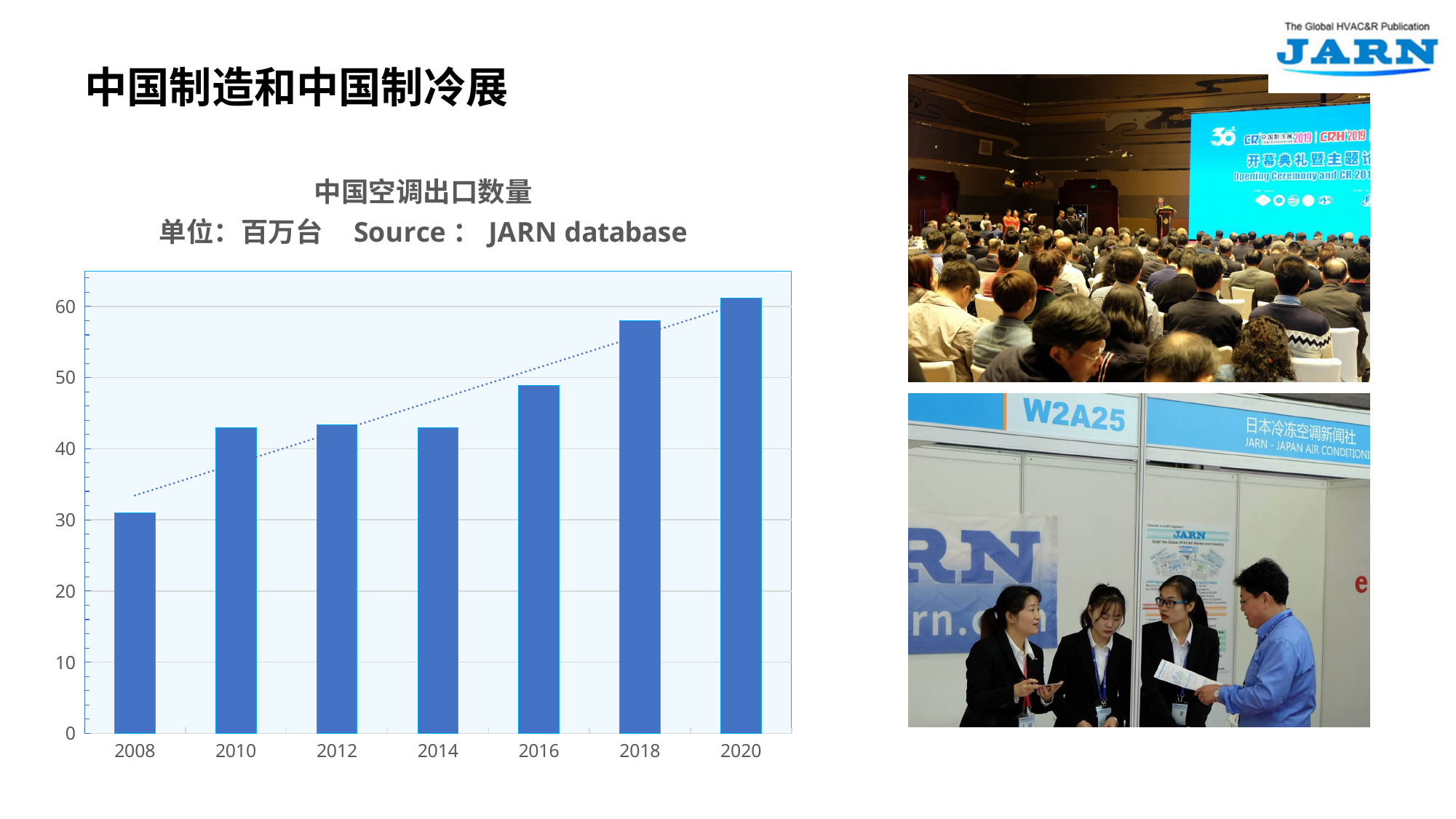
Which year has the lowest bar in the chart? 2008 Is the value for 2016 greater or less than 40? greater Which is larger, the value for 2018 or the value for 2014? 2018 What kind of chart is shown on the slide? bar chart Do the values generally rise or fall from 2008 to 2020? rise How many years are plotted on the x axis of the chart? 7 What unit is stated for the chart's values? 百万台 Is the value for 2010 greater or less than 40? greater Is the value for 2018 greater or less than 50? greater What is the title of the chart? 中国空调出口数量 Which year has the highest bar in the chart? 2020